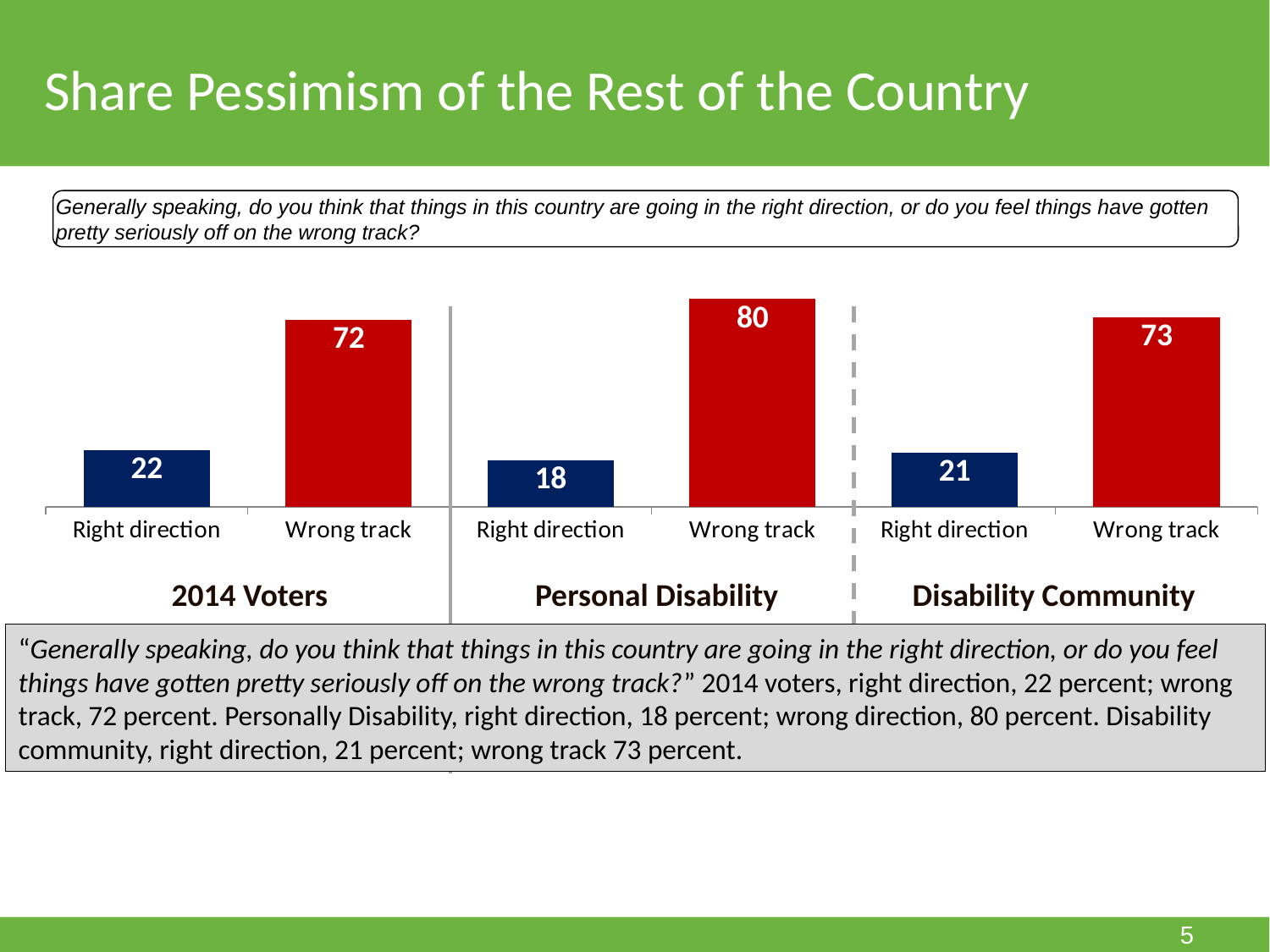
In the 2014 Voters chart, what is the value for Wrong track? 72 In the 2014 Voters chart, what is the value for Right direction? 22 Is the Wrong track value larger in the Personal Disability chart or the Disability Community chart? Personal Disability In the 2014 Voters chart, what is the difference between Wrong track and Right direction? 50 In the Disability Community chart, what is the value for Wrong track? 73 How many categories are shown in the Disability Community chart? 2 In the Personal Disability chart, what is the difference between Wrong track and Right direction? 62 In the Personal Disability chart, what is the value for Right direction? 18 In the Disability Community chart, which category has the lowest value? Right direction In the Personal Disability chart, which category has the highest value? Wrong track What kind of chart is used for the 2014 Voters data? Bar chart What colour are the Wrong track bars on the slide? Red